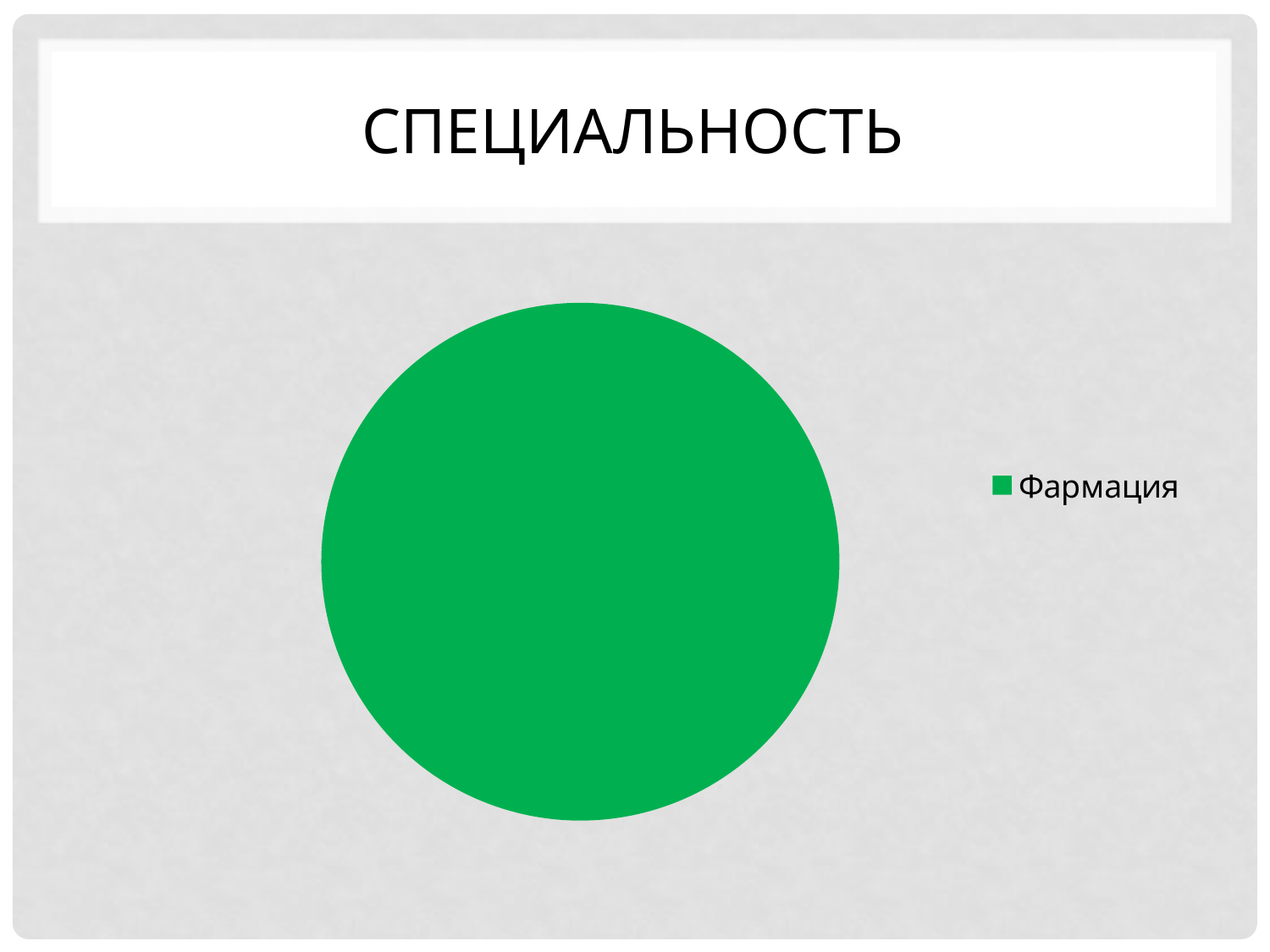
What kind of chart is shown on the slide? pie chart What is the title of the slide containing the pie chart? СПЕЦИАЛЬНОСТЬ What is the name of the only category shown in the pie chart's legend? Фармация How many entries does the legend of the pie chart list? 1 Which category is the largest in the pie chart? Фармация How many slices does the pie chart have? 1